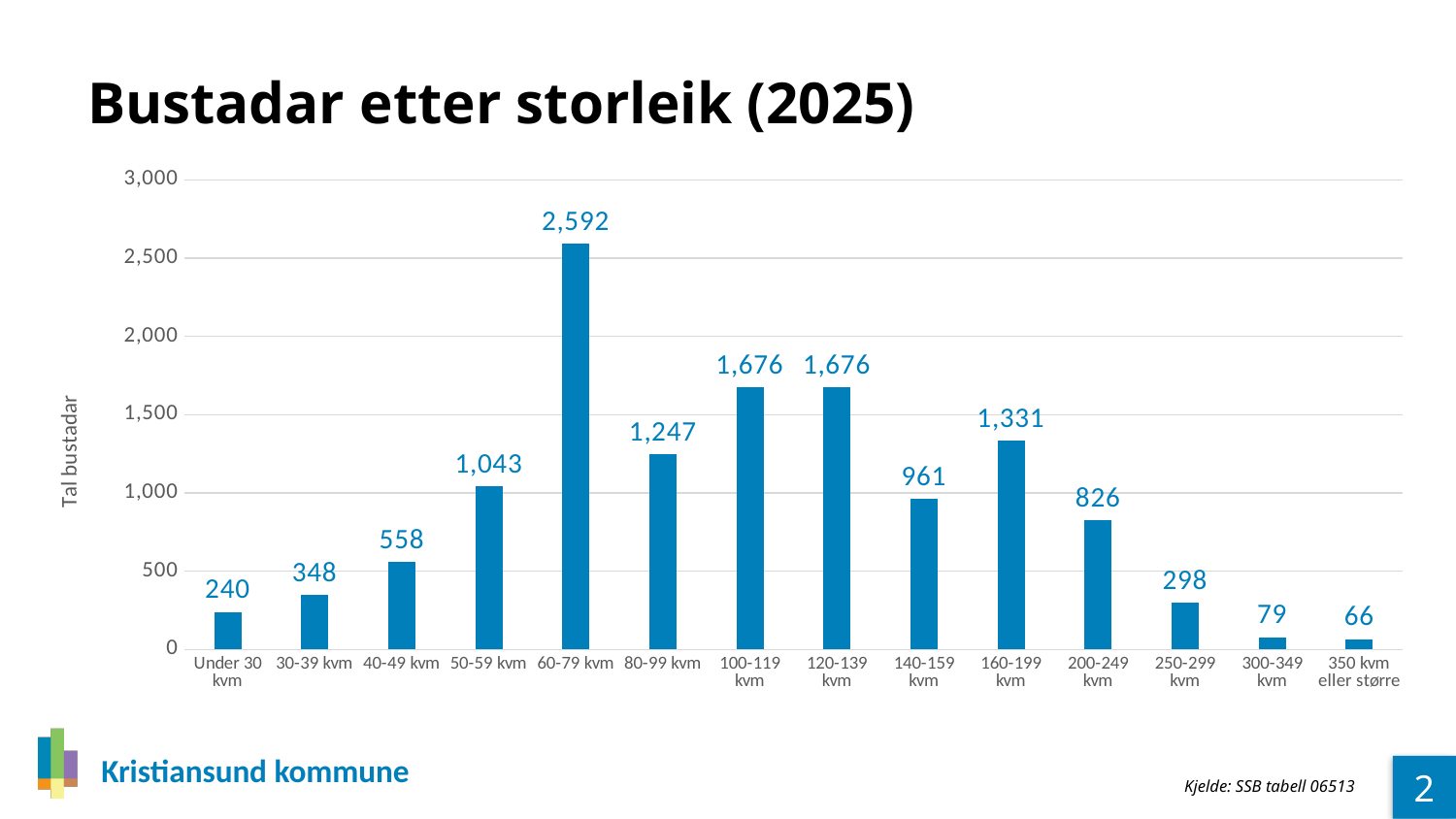
What is the value for 160-199 kvm? 1,331 What is the value for 350 kvm eller større? 66 What kind of chart is shown on the slide? bar chart What is the difference between the values for 60-79 kvm and 100-119 kvm? 916 What is the label on the y axis? Tal bustadar Which size category has the highest number of dwellings? 60-79 kvm What is the difference between the values for 80-99 kvm and 50-59 kvm? 204 How many size categories are shown on the x axis? 14 Which size category has the lowest number of dwellings? 350 kvm eller større What is the value for 60-79 kvm? 2,592 Is the value for 200-249 kvm greater or less than 1,000? less Which is larger, the value for 140-159 kvm or the value for 160-199 kvm? 160-199 kvm